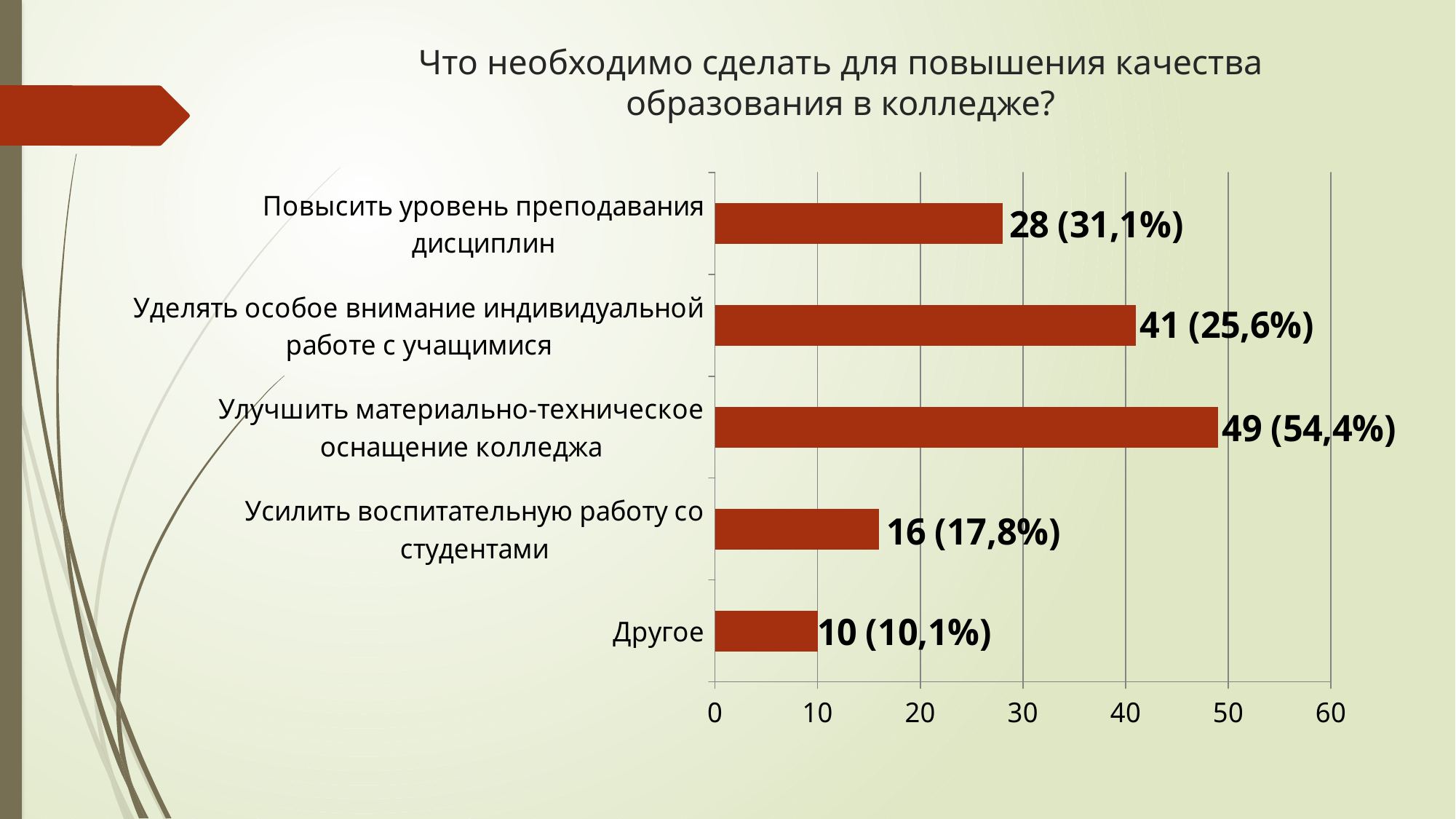
Which is larger: the count for "Повысить уровень преподавания дисциплин" or for "Усилить воспитательную работу со студентами"? Повысить уровень преподавания дисциплин What is the value for "Улучшить материально-техническое оснащение колледжа"? 49 (54,4%) Is the value for "Уделять особое внимание индивидуальной работе с учащимися" greater or less than 30? greater Which category has the lowest value? Другое What is the value for "Повысить уровень преподавания дисциплин"? 28 (31,1%) What is the value for "Другое"? 10 (10,1%) Which category has the highest value? Улучшить материально-техническое оснащение колледжа How many categories are shown in the chart? 5 What is the difference in count between "Улучшить материально-техническое оснащение колледжа" and "Уделять особое внимание индивидуальной работе с учащимися"? 8 What is the title of the slide? Что необходимо сделать для повышения качества образования в колледже? What is the value for "Усилить воспитательную работу со студентами"? 16 (17,8%) What kind of chart is shown on the slide? bar chart